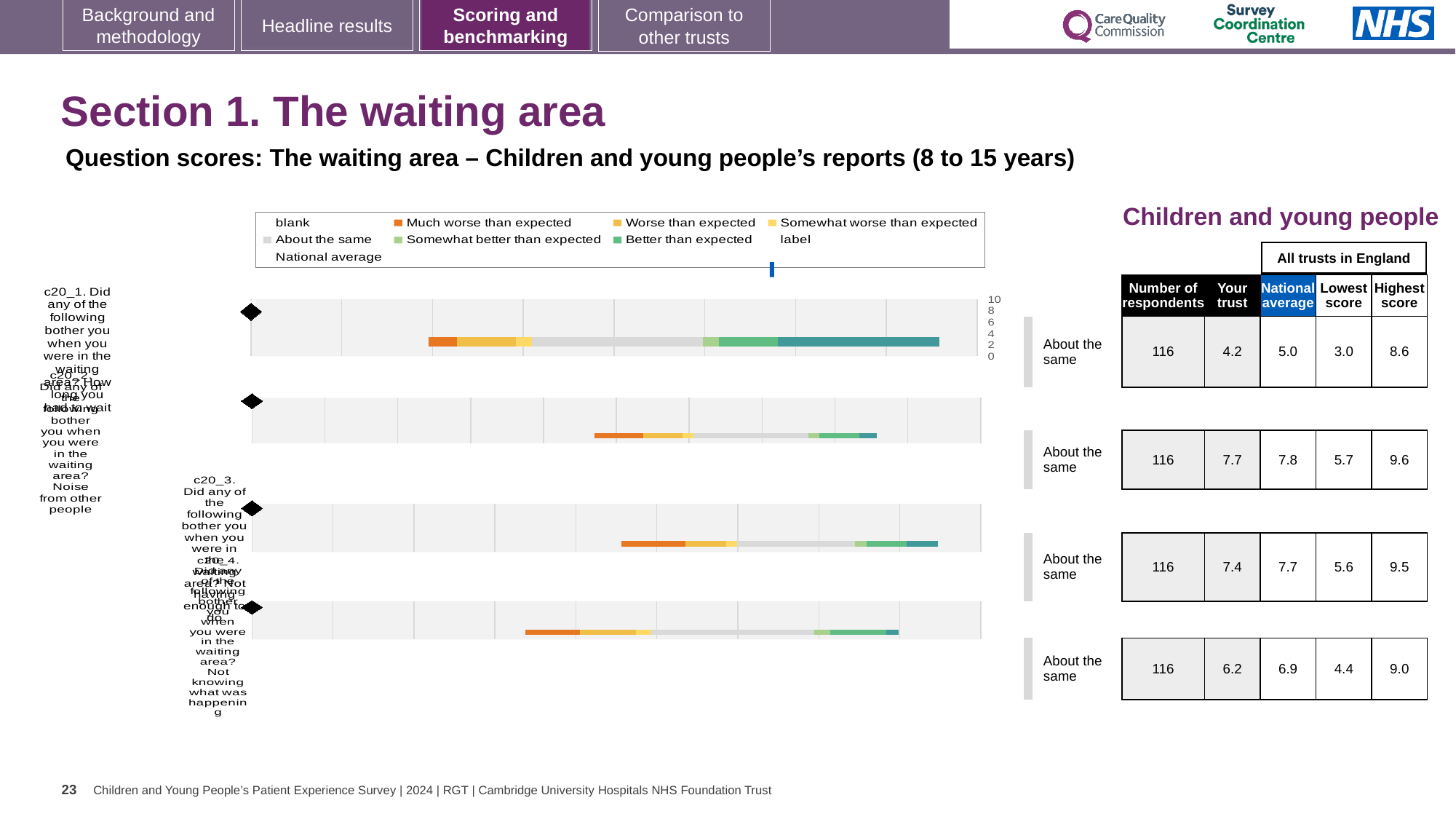
In the table next to the charts, what is the difference between the National average and 'Your trust' score for the fourth question (c20_4, Not knowing what was happening)? 0.7 In the table next to the charts, what is the 'Your trust' score for the first question (c20_1, Noise from other people)? 4.2 In the legend, which category is shown in orange? Much worse than expected How many entries does the legend above the charts list? 9 How many separate bar charts (one per question) are shown on the slide? 4 In the table next to the charts, how many respondents are listed for each question? 116 What kind of chart is used to show the question scores on this slide? bar chart In the table next to the charts, what is the National average for the second question (c20_2, How long you had to wait)? 7.8 In the table next to the charts, which question has the highest 'Your trust' score? c20_2 (How long you had to wait) What is the highest value shown on the axis scale to the right of the first bar chart? 10 In the table next to the charts, which question has the lowest 'Your trust' score? c20_1 (Noise from other people) In the legend, which category is shown in light grey? About the same